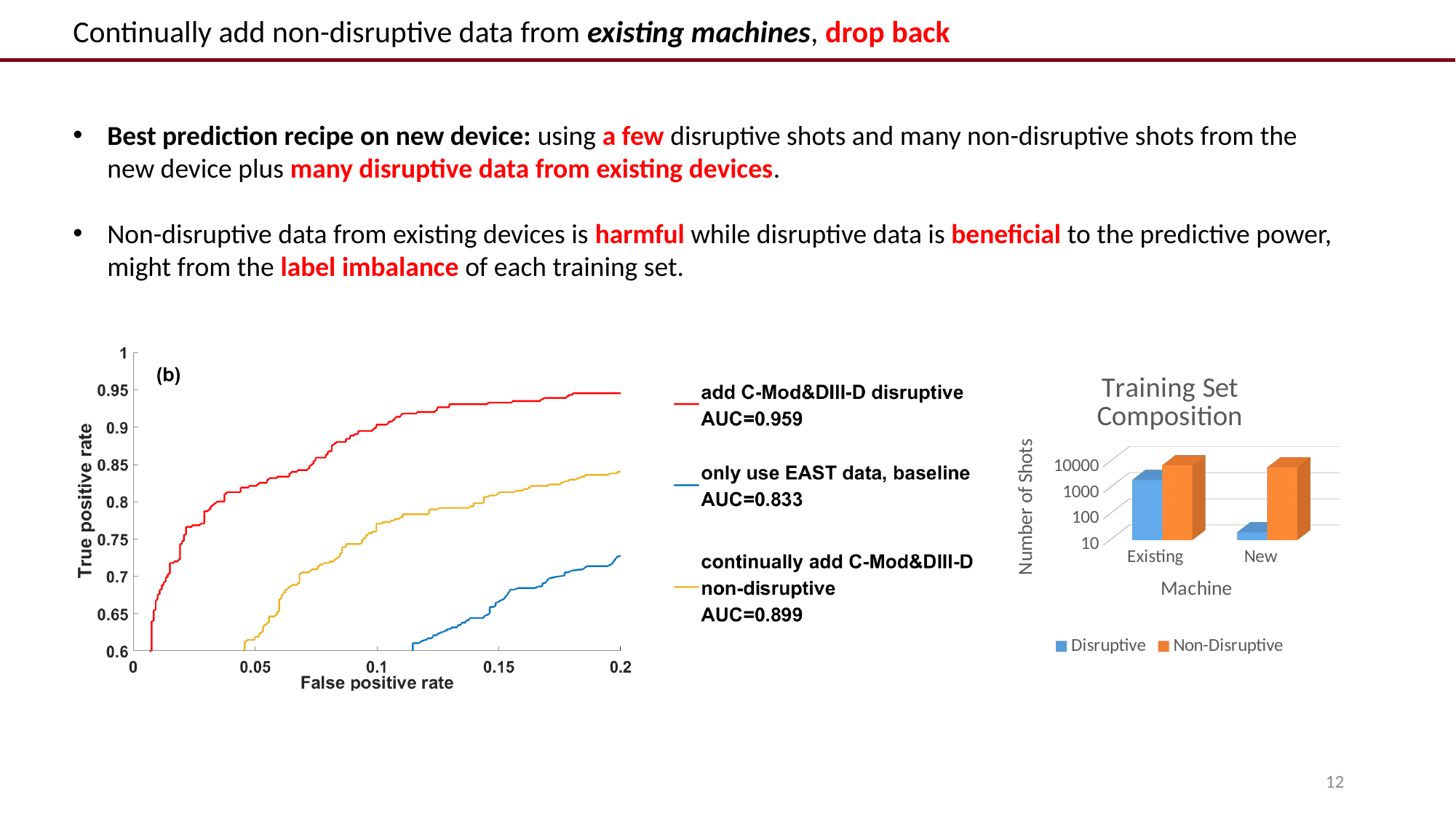
What kind of chart is the chart on the left of the slide? Line chart In the ROC chart on the left, what is the difference between the AUC of 'add C-Mod&DIII-D disruptive' and the AUC of 'continually add C-Mod&DIII-D non-disruptive'? 0.06 In the 'Training Set Composition' chart, which is larger for the New machine, Disruptive or Non-Disruptive? Non-Disruptive In the 'Training Set Composition' chart, is the Disruptive value for New greater or less than 100? less In the ROC chart on the left, how many curves are plotted? 3 In the 'Training Set Composition' chart, how many machine categories are shown on the x axis? 2 In the ROC chart on the left, what is the AUC of the 'only use EAST data, baseline' curve? 0.833 In the 'Training Set Composition' chart, is the Disruptive value for Existing greater or less than 1000? greater In the 'Training Set Composition' chart, how many series does the legend list? 2 In the ROC chart on the left, which curve has the highest AUC? add C-Mod&DIII-D disruptive In the ROC chart on the left, which curve has the lowest AUC? only use EAST data, baseline In the ROC chart on the left, what is the AUC of the 'add C-Mod&DIII-D disruptive' curve? 0.959